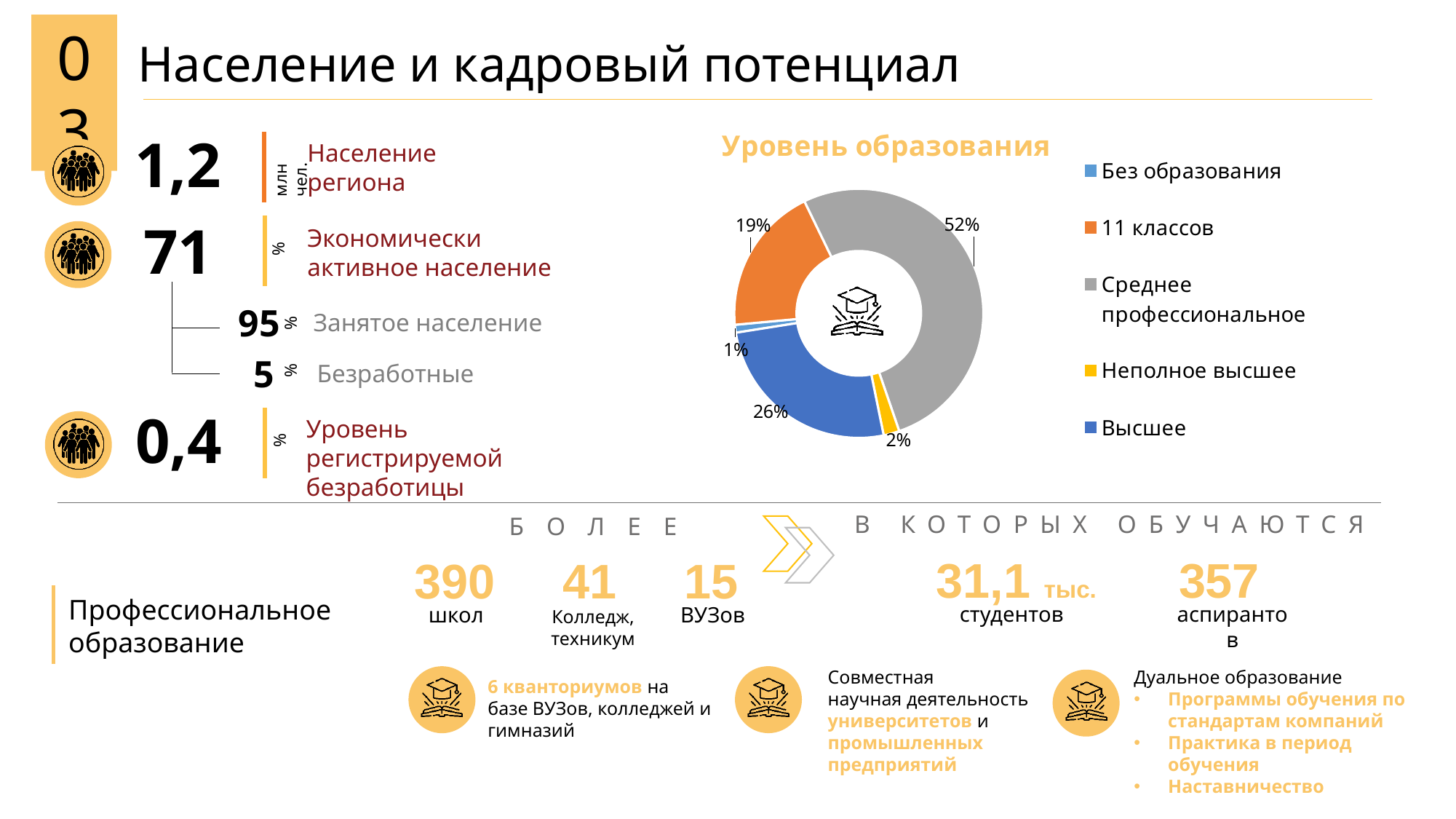
How many categories does the legend of the "Уровень образования" chart list? 5 What type of chart is shown under the title "Уровень образования"? doughnut chart What share of the "Уровень образования" chart is "Неполное высшее"? 2% Which category has the largest share in the "Уровень образования" chart? Среднее профессиональное What is the title of the chart on the slide? Уровень образования In the "Уровень образования" chart, which is larger: "11 классов" or "Высшее"? Высшее What share of the "Уровень образования" chart is "11 классов"? 19% In the "Уровень образования" chart, how many percentage points larger is "Среднее профессиональное" than "Высшее"? 26 What share of the "Уровень образования" chart is "Высшее"? 26% Which category has the smallest share in the "Уровень образования" chart? Без образования What share of the "Уровень образования" chart is "Среднее профессиональное"? 52% What share of the "Уровень образования" chart is "Без образования"? 1%